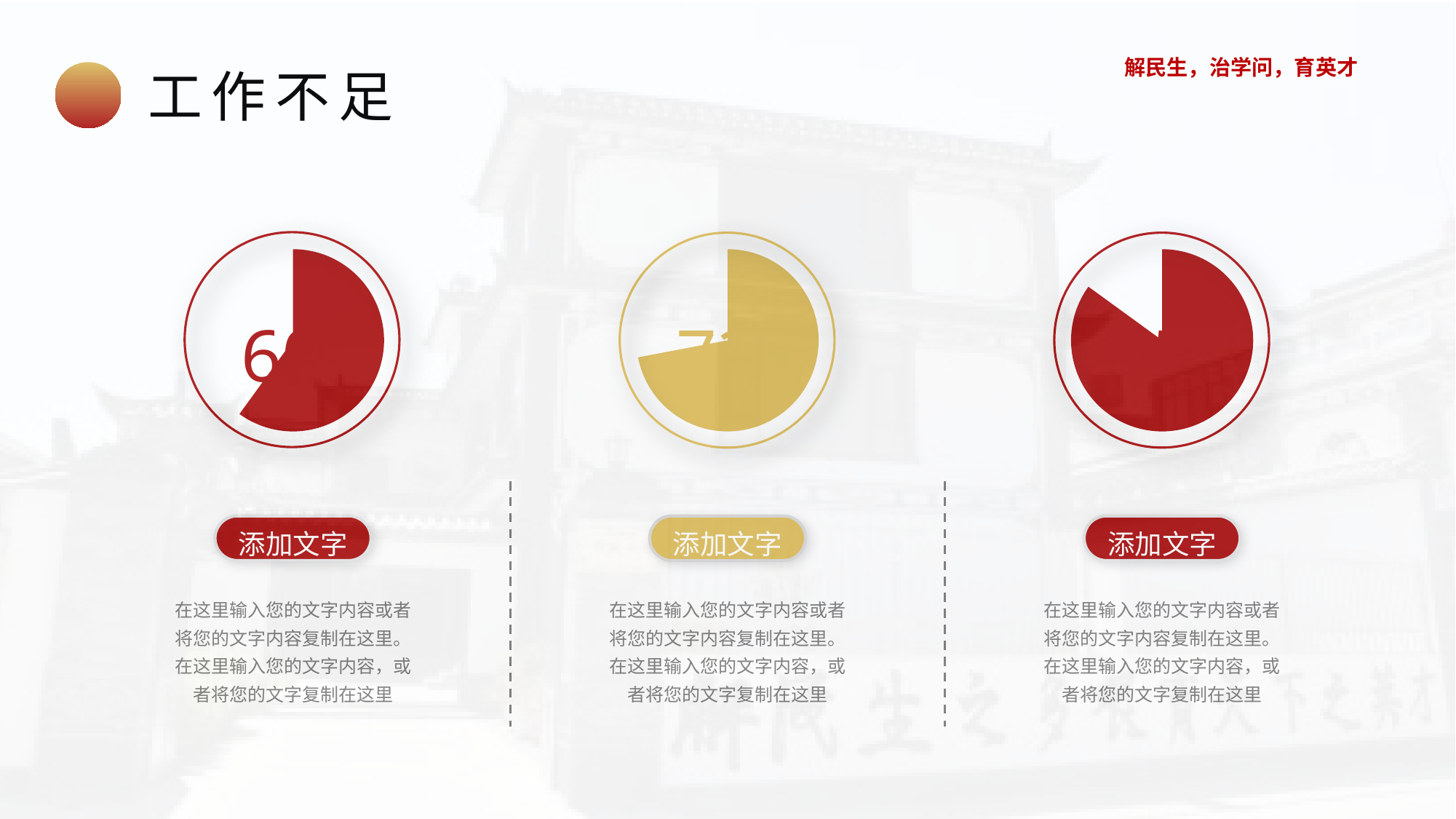
Which of the three pie charts has the smallest filled slice? the left pie chart Which of the three pie charts has the largest filled slice? the right pie chart What colour is the filled slice of the middle pie chart? gold How many pie charts are on the slide? 3 What kind of chart is shown in each of the three circles on the slide? pie chart Comparing the left pie chart and the right pie chart, which one has the larger filled slice? the right pie chart Comparing the left pie chart and the middle pie chart, which one has the larger filled slice? the middle pie chart What colour are the filled slices of the left and right pie charts? red